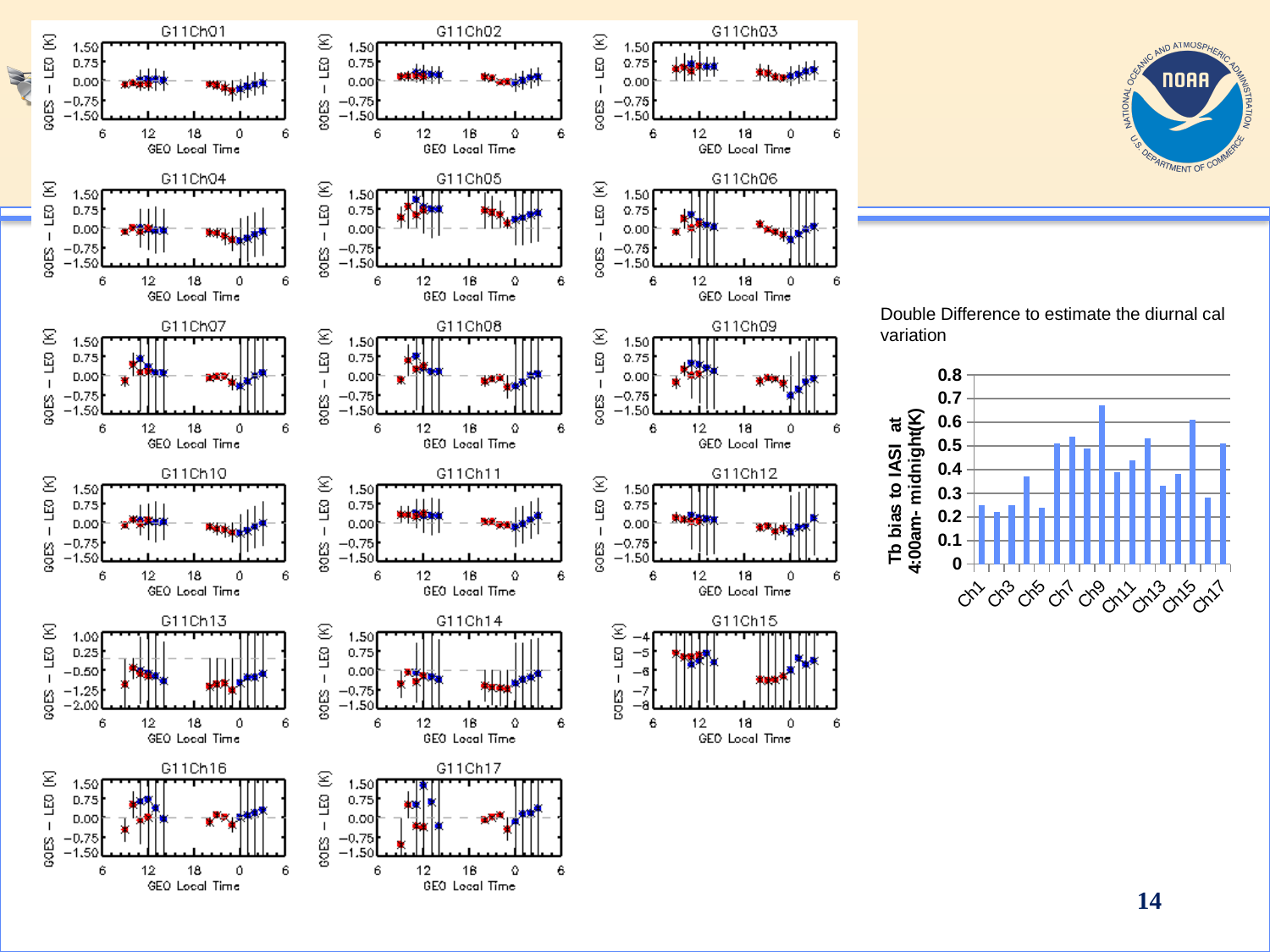
In the bar chart on the right, which has the larger Tb bias, Ch7 or Ch5? Ch7 In the bar chart on the right, which channel has the highest Tb bias to IASI? Ch9 How many small GOES - LEO panels (G11Ch01 to G11Ch17) are shown on the left side of the slide? 17 In the bar chart on the right, which has the larger Tb bias, Ch15 or Ch16? Ch15 In the bar chart on the right, which has the larger Tb bias, Ch9 or Ch1? Ch9 In the bar chart on the right, is the value for Ch1 greater or less than 0.3? less In the bar chart on the right, is the value for Ch13 greater or less than 0.4? less In the bar chart on the right, is the value for Ch15 greater or less than 0.5? greater What kind of chart is the chart on the right side of the slide showing Tb bias to IASI? bar chart What is the y-axis label of the bar chart on the right? Tb bias to IASI at 4:00am- midnight(K) In the bar chart on the right, how many channels are plotted along the x axis? 17